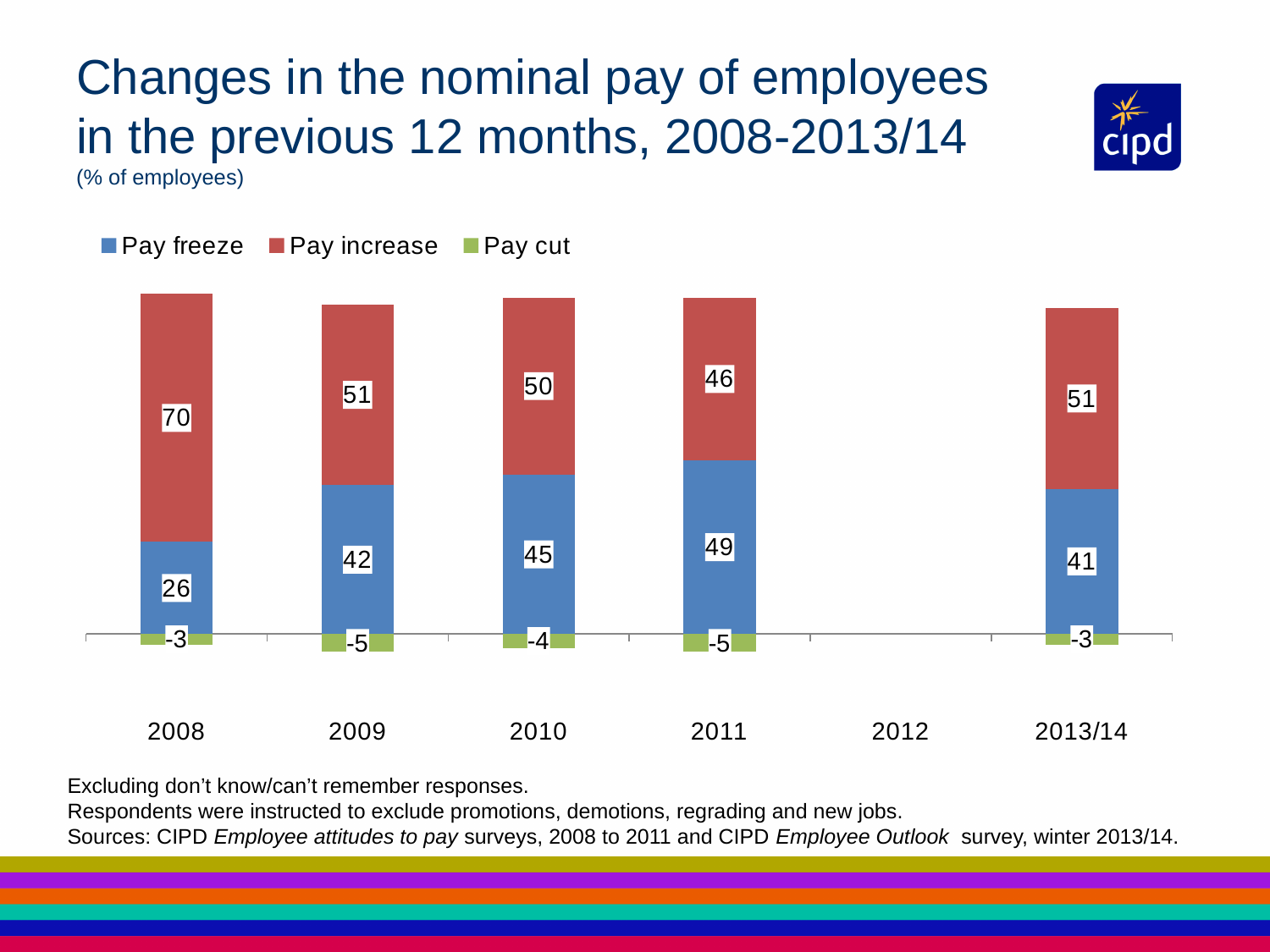
What is the Pay increase value for 2008? 70 Does the Pay freeze value rise or fall from 2008 to 2011? Rise How many series does the legend list? 3 What is the Pay freeze value for 2011? 49 What kind of chart is shown on the slide? Stacked bar chart What is the difference between the Pay freeze values for 2011 and 2008? 23 What is the Pay freeze value for 2013/14? 41 Which year has the highest Pay increase value? 2008 Which year has the lowest Pay freeze value? 2008 What is the Pay cut value for 2009? -5 Which is larger in 2011, the Pay freeze value or the Pay increase value? Pay freeze Which year on the x axis has no bar plotted? 2012